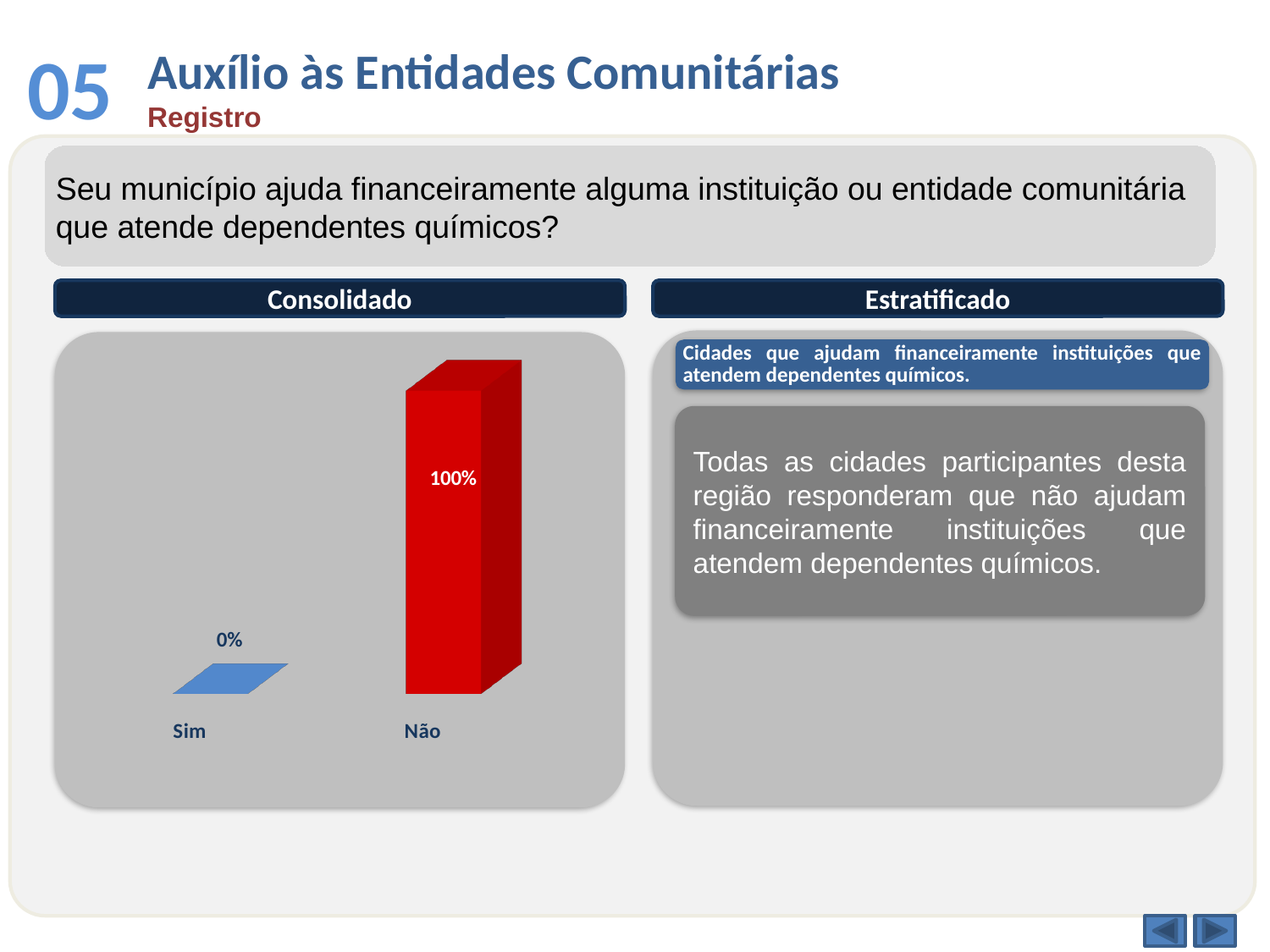
What is the value for Sim in the Consolidado chart? 0% What is the difference between the values for Não and Sim in the Consolidado chart? 100% What is the value for Não in the Consolidado chart? 100% How many categories are shown in the Consolidado chart? 2 What colour is the bar for Não in the Consolidado chart? red What kind of chart is shown under Consolidado? bar chart Which category has the lowest value in the Consolidado chart? Sim Which category has the highest value in the Consolidado chart? Não What colour is the bar for Sim in the Consolidado chart? blue Which is larger in the Consolidado chart, the value for Sim or the value for Não? Não